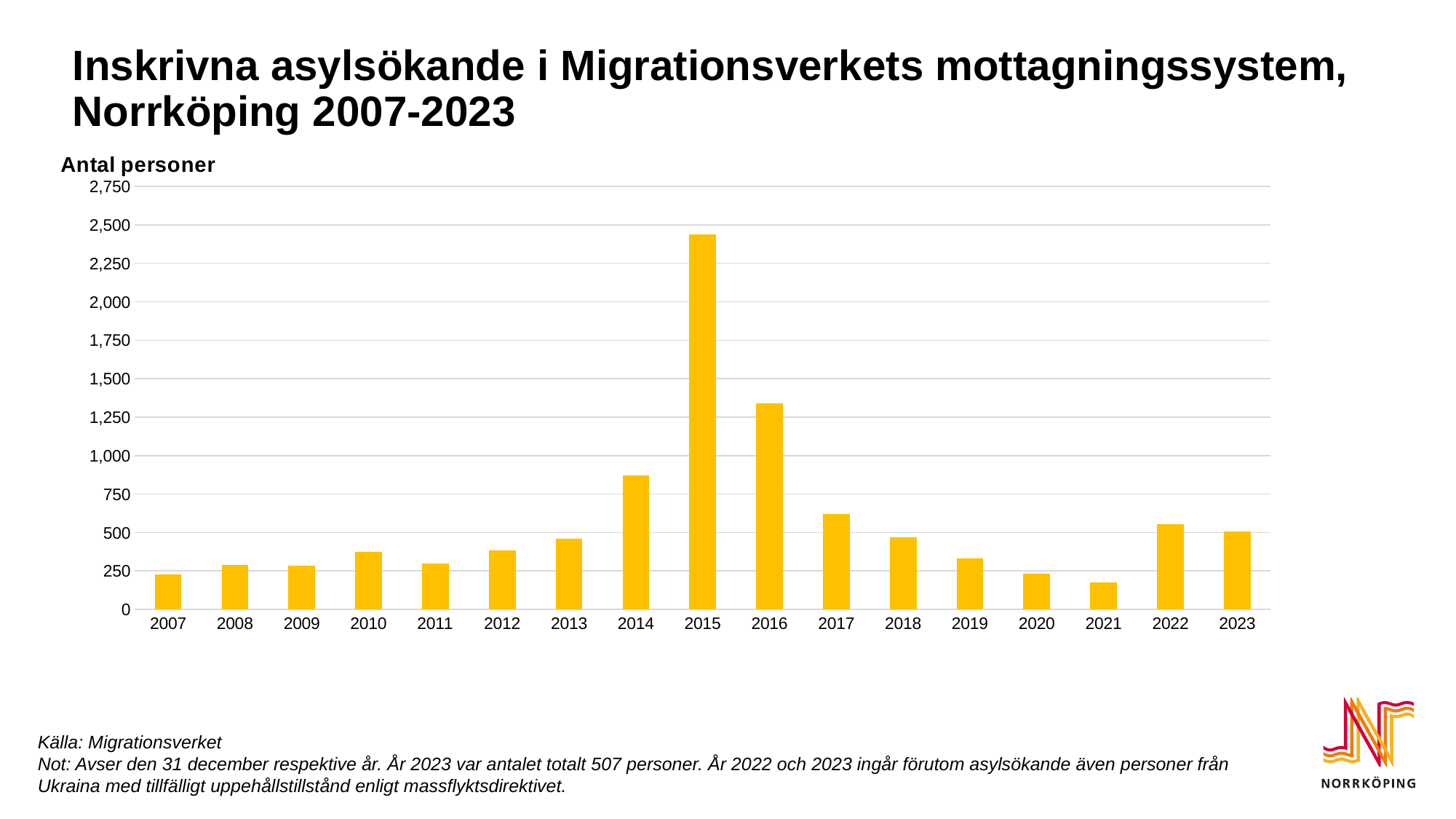
According to the note on the slide, how many persons were registered in 2023? 507 Is the value for 2021 greater or less than 250? less Is the value for 2015 greater or less than 2,250? greater What type of chart is shown on the slide? Bar chart Is the value for 2017 greater or less than 750? less Which year has the highest number of registered asylum seekers? 2015 How many years are shown on the x axis? 17 Which year has a higher value, 2014 or 2016? 2016 What is the label of the y axis? Antal personer Which year has the lowest number of registered asylum seekers? 2021 Do the values rise or fall from 2015 to 2021? fall